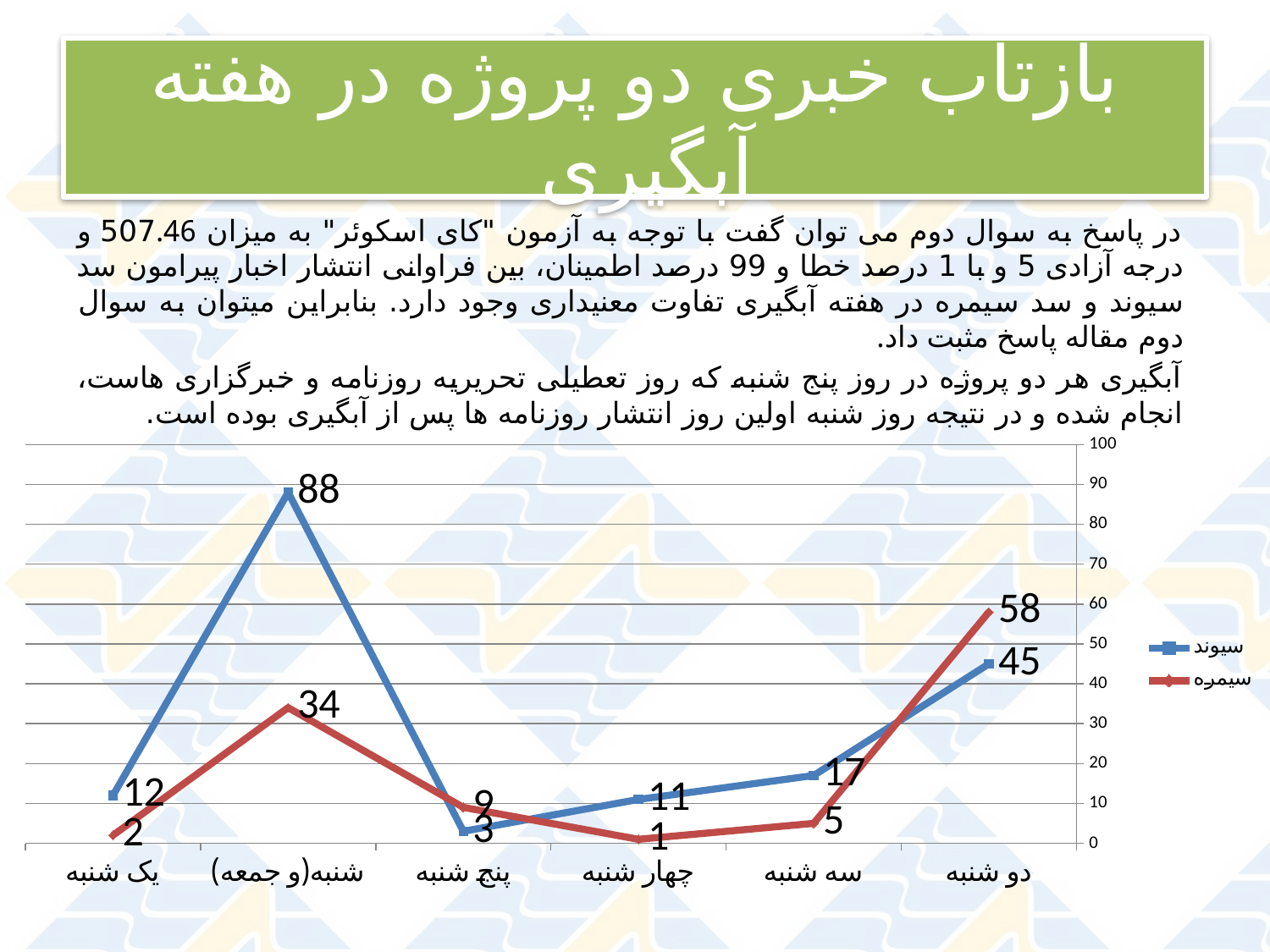
What kind of chart is shown on the slide? line chart How many categories are shown on the x axis? 6 Is the value for سیوند on سه شنبه greater or less than 20? less What is the value for سیوند on پنج شنبه? 3 Which series has the larger value on دو شنبه, سیوند or سیمره? سیمره What is the value for سیمره on دو شنبه? 58 What is the difference between سیوند and سیمره on شنبه(و جمعه)? 54 On which day does سیوند reach its highest value? شنبه(و جمعه) Which colour is used for the سیمره series? red What is the value for سیوند on شنبه(و جمعه)? 88 How many series does the legend list? 2 On which day does سیمره have its lowest value? چهار شنبه